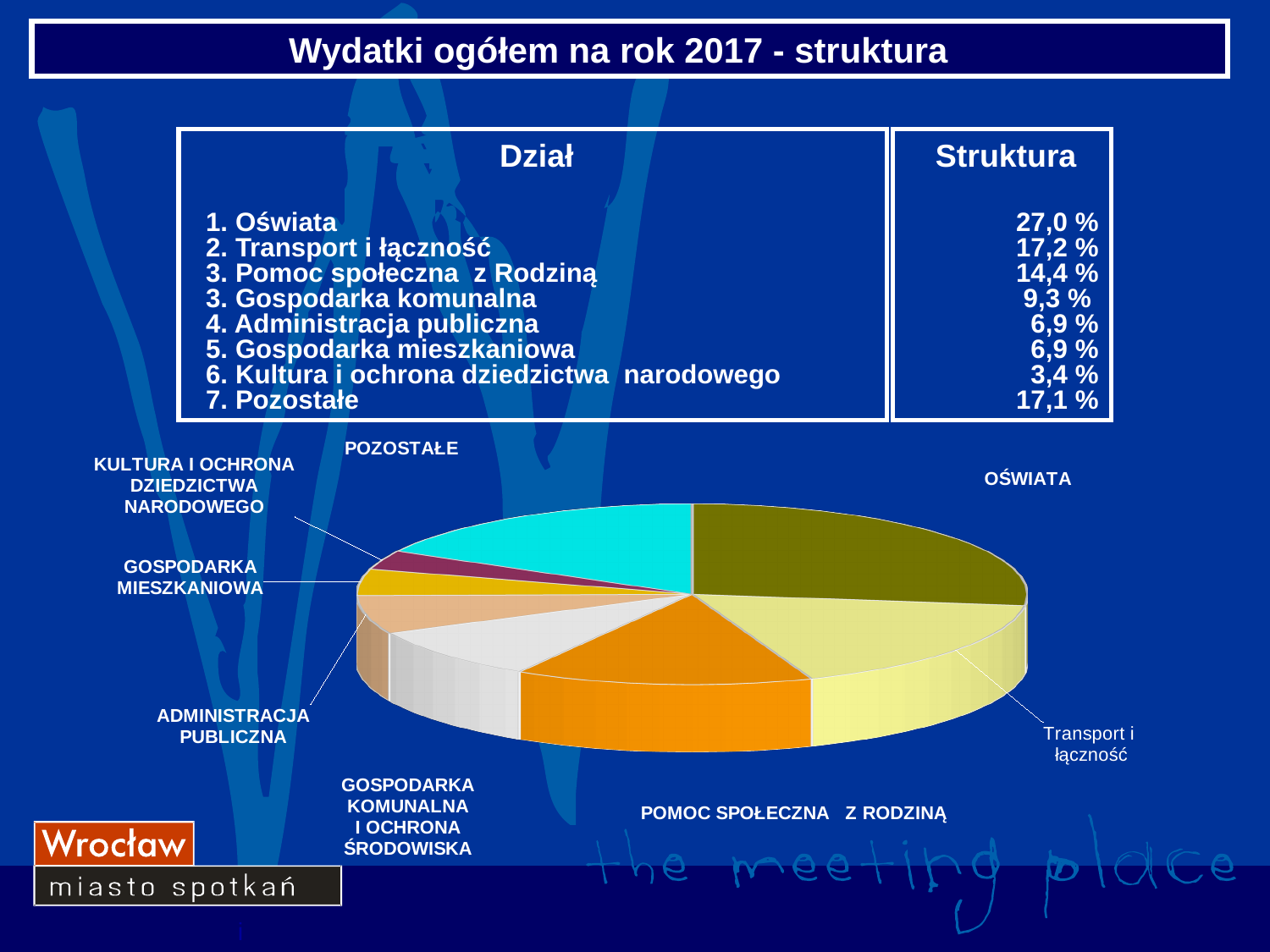
Which category has the smallest slice of the pie? Kultura i ochrona dziedzictwa narodowego Which category is represented by the cyan slice of the pie? Pozostałe What kind of chart is shown on the slide? pie chart Which is larger, the share for Transport i łączność or the share for Pozostałe? Transport i łączność What share is shown for Pomoc społeczna z Rodziną? 14,4 % Which category has the largest slice of the pie? Oświata What share is shown for Kultura i ochrona dziedzictwa narodowego? 3,4 % How many slices does the pie chart have? 8 What share of total expenditure does Oświata have according to the slide? 27,0 % What share is shown for Transport i łączność? 17,2 % What is the difference in percentage points between the shares of Oświata and Pomoc społeczna z Rodziną? 12,6 What is the title of the slide containing the pie chart? Wydatki ogółem na rok 2017 - struktura